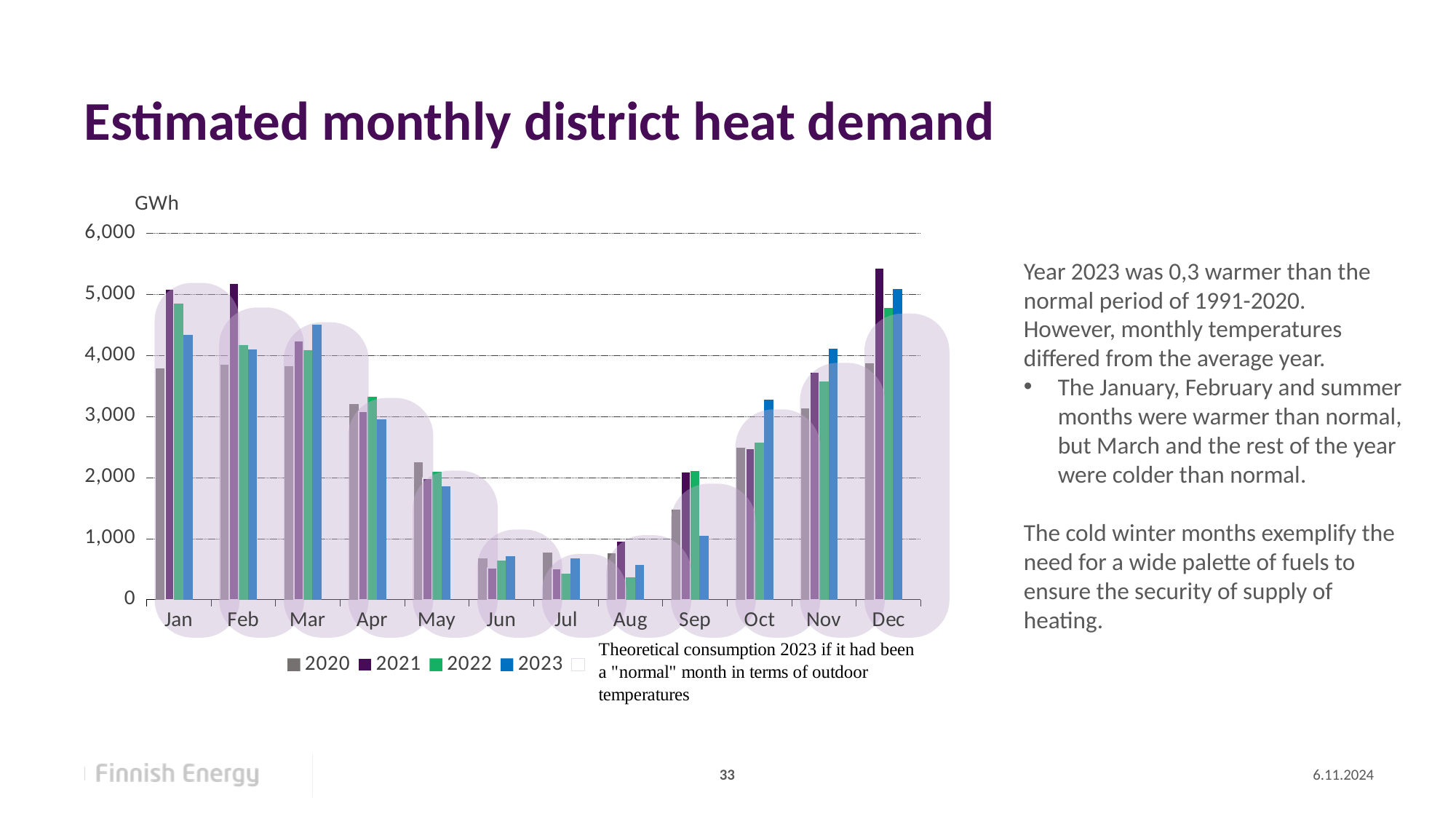
Do the 2020 values rise or fall from Jan to Jul? fall Is the 2022 value for Jul greater or less than 1,000? less What kind of chart is shown on the slide? bar chart Which month has the highest 2023 value? Dec Is the 2023 value for Oct greater or less than 3,000? greater What unit is shown on the y axis of the chart? GWh Is the 2023 value for Mar greater or less than 4,000? greater Which month has the lowest 2022 value? Aug For Jan, which is larger: the 2020 value or the 2021 value? 2021 How many months (categories) are shown on the x axis of the chart? 12 How many series does the chart legend list? 5